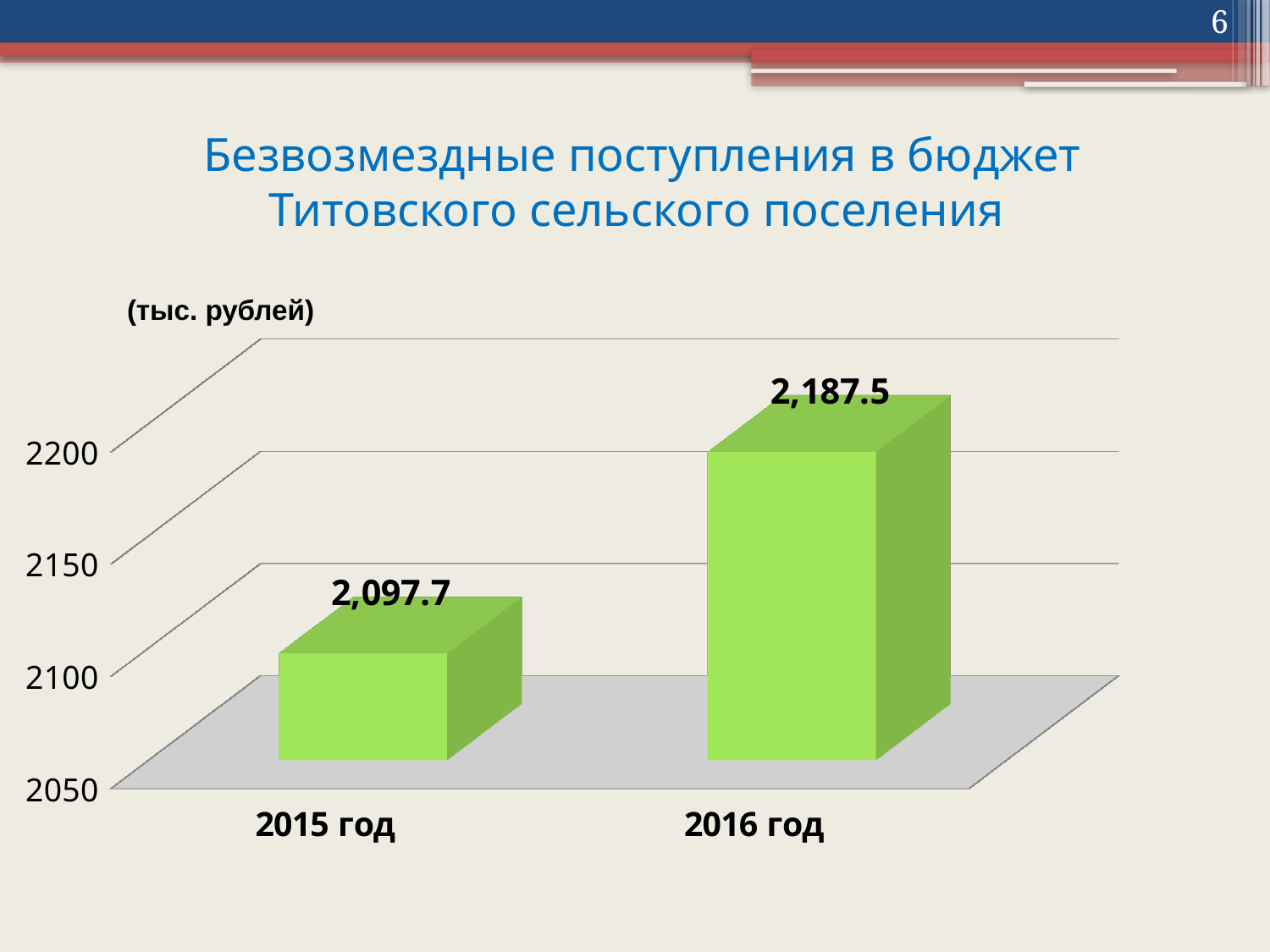
How many categories are shown on the chart? 2 What is the difference between the values for 2016 год and 2015 год? 89.8 What is the value for 2015 год? 2,097.7 What unit is indicated above the chart? тыс. рублей Is the value for 2016 год greater or less than 2150? greater Is the value for 2015 год greater or less than 2150? less What kind of chart is shown on the slide? bar chart Which year has the lowest value? 2015 год Do the values rise or fall from 2015 год to 2016 год? rise Which year has the highest value? 2016 год What is the value for 2016 год? 2,187.5 Which is larger, the value for 2015 год or 2016 год? 2016 год